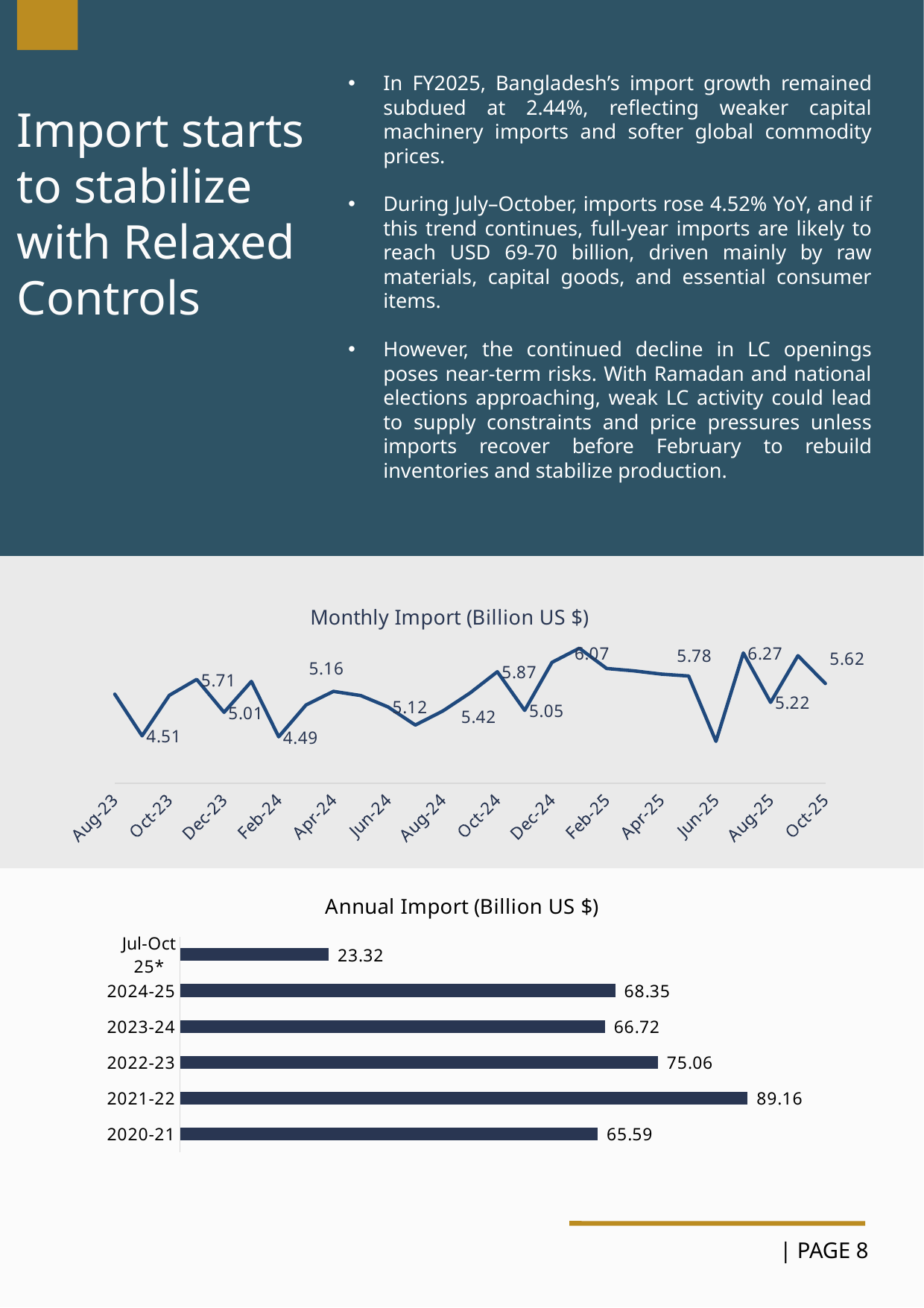
In the Annual Import (Billion US $) chart, what is the value for Jul-Oct 25*? 23.32 In the Annual Import (Billion US $) chart, which category has the lowest value? Jul-Oct 25* In the Annual Import (Billion US $) chart, which is larger, the value for 2022-23 or the value for 2024-25? 2022-23 In the Annual Import (Billion US $) chart, which category has the highest value? 2021-22 What kind of chart is the Monthly Import (Billion US $) chart? Line chart What kind of chart is the Annual Import (Billion US $) chart? Bar chart In the Annual Import (Billion US $) chart, what is the difference between the values for 2021-22 and 2022-23? 14.10 In the Annual Import (Billion US $) chart, what is the difference between the values for 2024-25 and 2023-24? 1.63 In the Monthly Import (Billion US $) chart, what is the value labelled at the last point, Oct-25? 5.62 How many categories are shown in the Annual Import (Billion US $) chart? 6 In the Annual Import (Billion US $) chart, what is the value for 2023-24? 66.72 In the Annual Import (Billion US $) chart, what is the value for 2021-22? 89.16